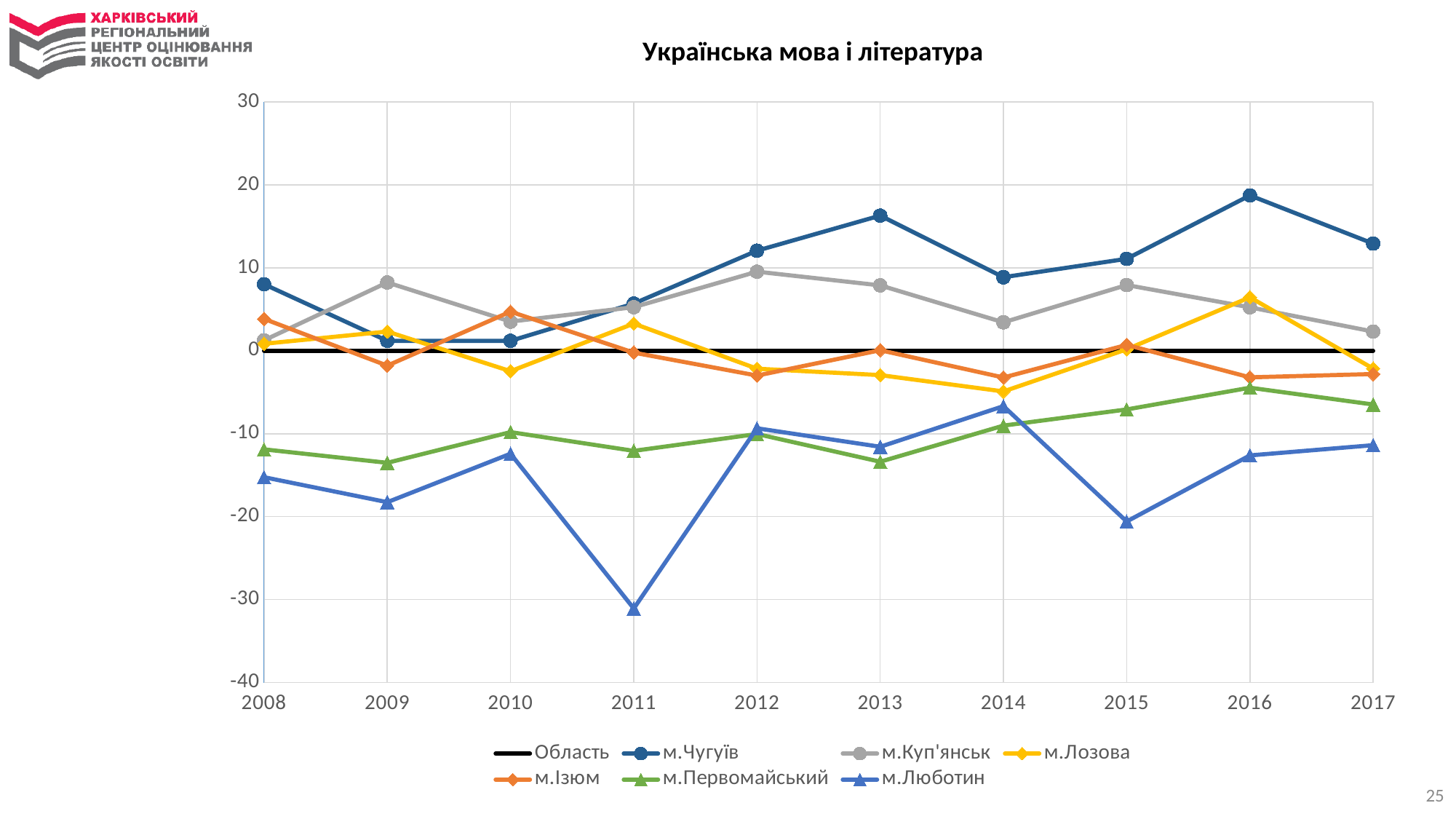
How many years are shown along the x axis? 10 In 2010, which is higher: м.Ізюм or м.Лозова? м.Ізюм Is the value for м.Чугуїв in 2016 greater or less than 10? greater How many series does the legend list? 7 Is the value for м.Первомайський in 2008 greater or less than -10? less Which series is drawn as a flat black line at 0? Область In which year does м.Чугуїв reach its highest value? 2016 Which series has the highest value in 2017? м.Чугуїв What kind of chart is shown on the slide? line chart Is the value for м.Люботин in 2011 greater or less than -20? less In which year does м.Люботин reach its lowest value? 2011 What is the title of the chart? Українська мова і література